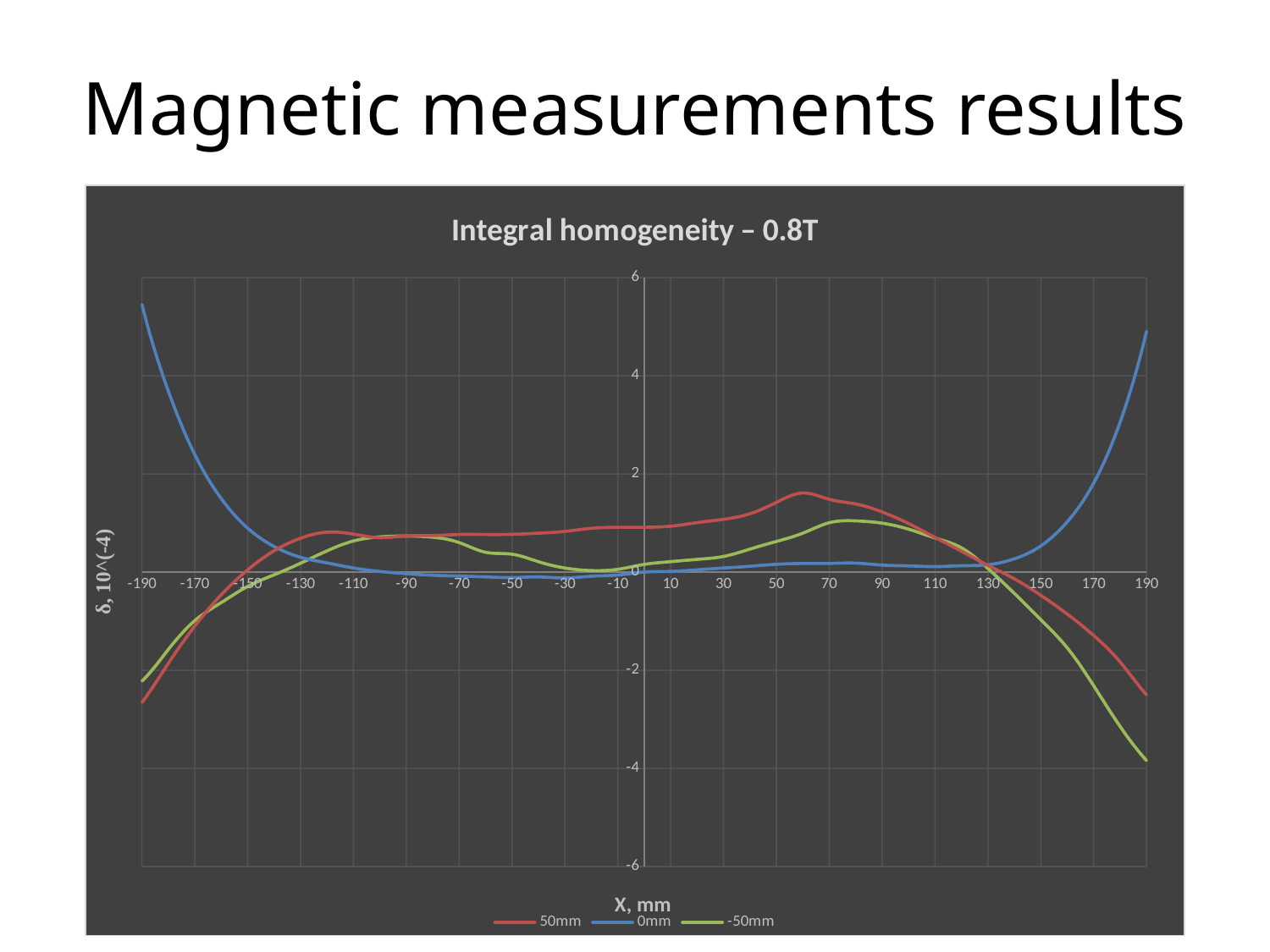
Is the value of the 50mm series at X = -190 mm greater or less than -2? less Which series has the highest value at X = 190 mm? 0mm Which series has the lowest value at X = -190 mm? 50mm What is the title of the chart? Integral homogeneity – 0.8T How many series does the legend of the chart list? 3 What kind of chart is shown on the slide? line chart What are the three series named in the chart legend? 50mm, 0mm, -50mm Does the 0mm series rise or fall as X goes from 0 mm to 190 mm? rises Is the value of the 50mm series at X = 60 mm greater or less than 1? greater Is the value of the -50mm series at X = 190 mm greater or less than -2? less